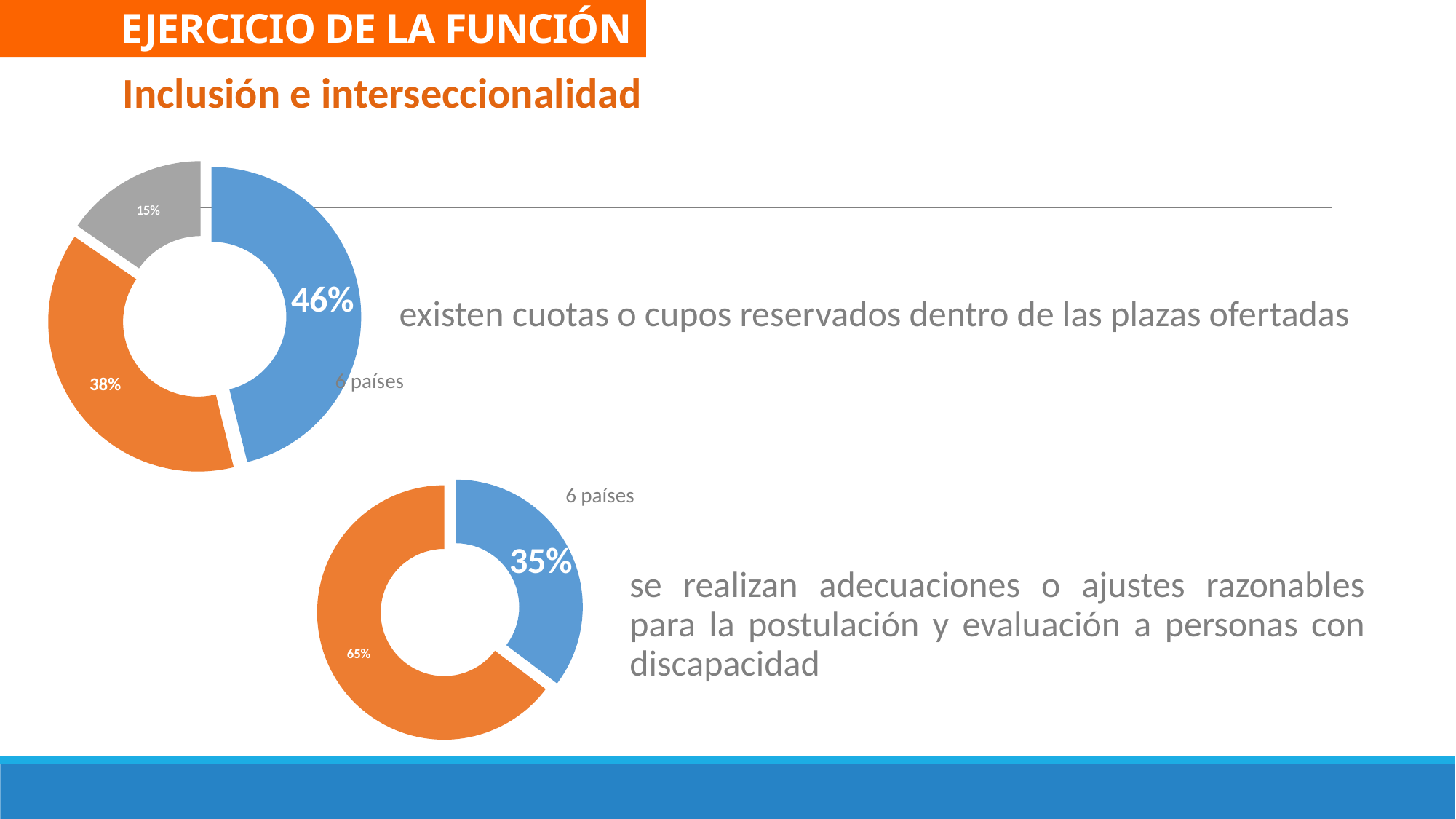
On the bottom doughnut chart, what percentage does the blue slice show? 35% What kind of chart is the bottom chart on the slide? Doughnut (pie) chart On the top-left doughnut chart, which colour slice is the smallest? Grey On the bottom doughnut chart, which is larger, the blue slice or the orange slice? Orange On the top-left doughnut chart, which colour slice is the largest? Blue On the bottom doughnut chart, what is the difference between the orange slice and the blue slice? 30% On the top-left doughnut chart, what percentage does the orange slice show? 38% How many slices does the top-left doughnut chart have? 3 On the top-left doughnut chart, what percentage does the blue slice show? 46% On the bottom doughnut chart, what percentage does the orange slice show? 65% On the top-left doughnut chart, what is the difference between the blue slice and the orange slice? 8% On the top-left doughnut chart, what percentage does the grey slice show? 15%